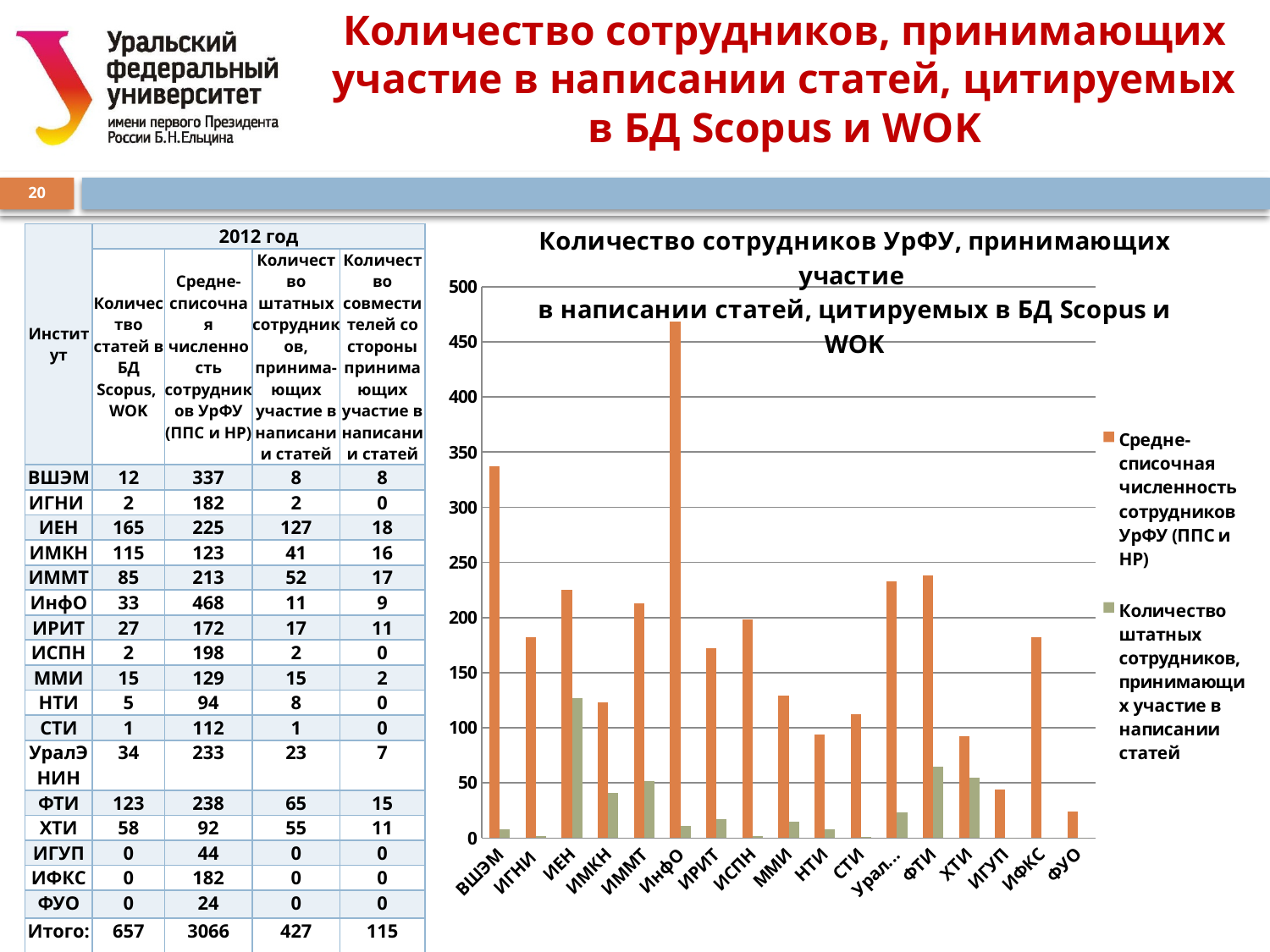
Is the average headcount value for ИнфО greater or less than 450? greater Which is larger: the average headcount for ФТИ or for ИФКС? ФТИ Which is larger: the number of staff participating in writing articles for ИЕН or for ФТИ? ИЕН Is the average headcount value for ВШЭМ greater or less than 300? greater Which institute has the highest number of staff participating in writing articles (green series)? ИЕН How many institutes (categories) are shown along the x axis of the chart? 17 Is the average headcount value for ХТИ greater or less than 100? less Which institute has the lowest average headcount (Средне-списочная численность) in the chart? ФУО What colour are the bars for the series 'Средне-списочная численность сотрудников УрФУ (ППС и НР)'? orange Which institute has the highest average headcount (Средне-списочная численность) in the chart? ИнфО What kind of chart is shown on the slide? bar chart How many series does the chart legend list? 2